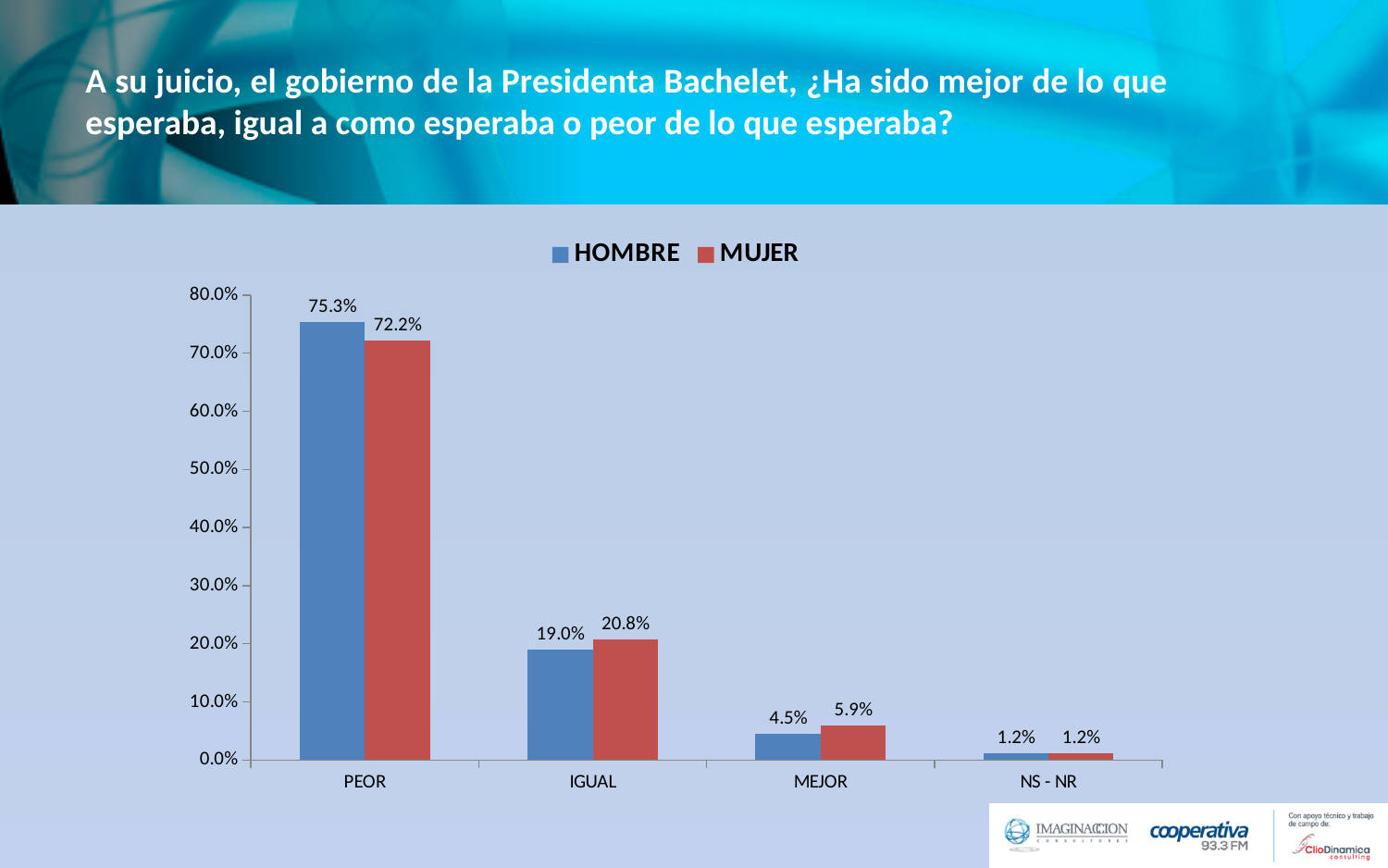
What is the MUJER value for MEJOR? 5.9% For IGUAL, which is larger, the HOMBRE value or the MUJER value? MUJER Which category has the highest HOMBRE value? PEOR What is the HOMBRE value for NS - NR? 1.2% Is the MUJER value for PEOR greater or less than 70.0%? greater What kind of chart is shown on the slide? bar chart Which category has the lowest MUJER value? NS - NR What is the HOMBRE value for PEOR? 75.3% What is the MUJER value for IGUAL? 20.8% How many series does the legend list? 2 How many categories are shown on the x axis? 4 What is the difference between the HOMBRE and MUJER values for PEOR? 3.1%